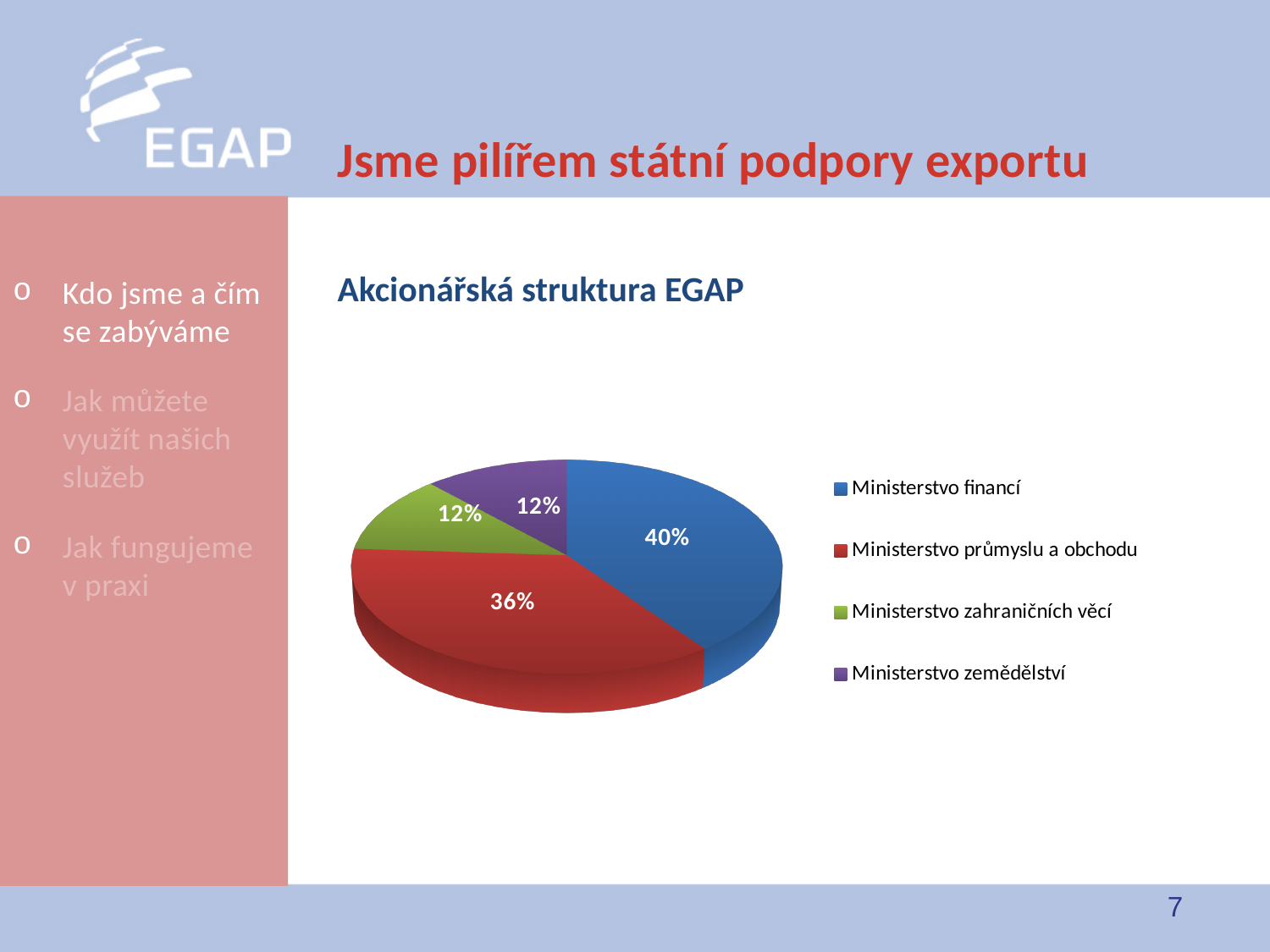
What kind of chart is shown on the slide? Pie chart Which is larger, the share of Ministerstvo financí or the share of Ministerstvo zahraničních věcí? Ministerstvo financí What share of the pie does Ministerstvo financí hold? 40% What is the title of the chart? Akcionářská struktura EGAP What share of the pie does Ministerstvo zemědělství hold? 12% What share of the pie does Ministerstvo zahraničních věcí hold? 12% Which colour represents Ministerstvo zemědělství in the legend? Purple How many categories does the pie chart show? 4 What is the difference between the shares of Ministerstvo financí and Ministerstvo průmyslu a obchodu? 4% What is the difference between the shares of Ministerstvo průmyslu a obchodu and Ministerstvo zemědělství? 24% Which category has the largest slice of the pie? Ministerstvo financí